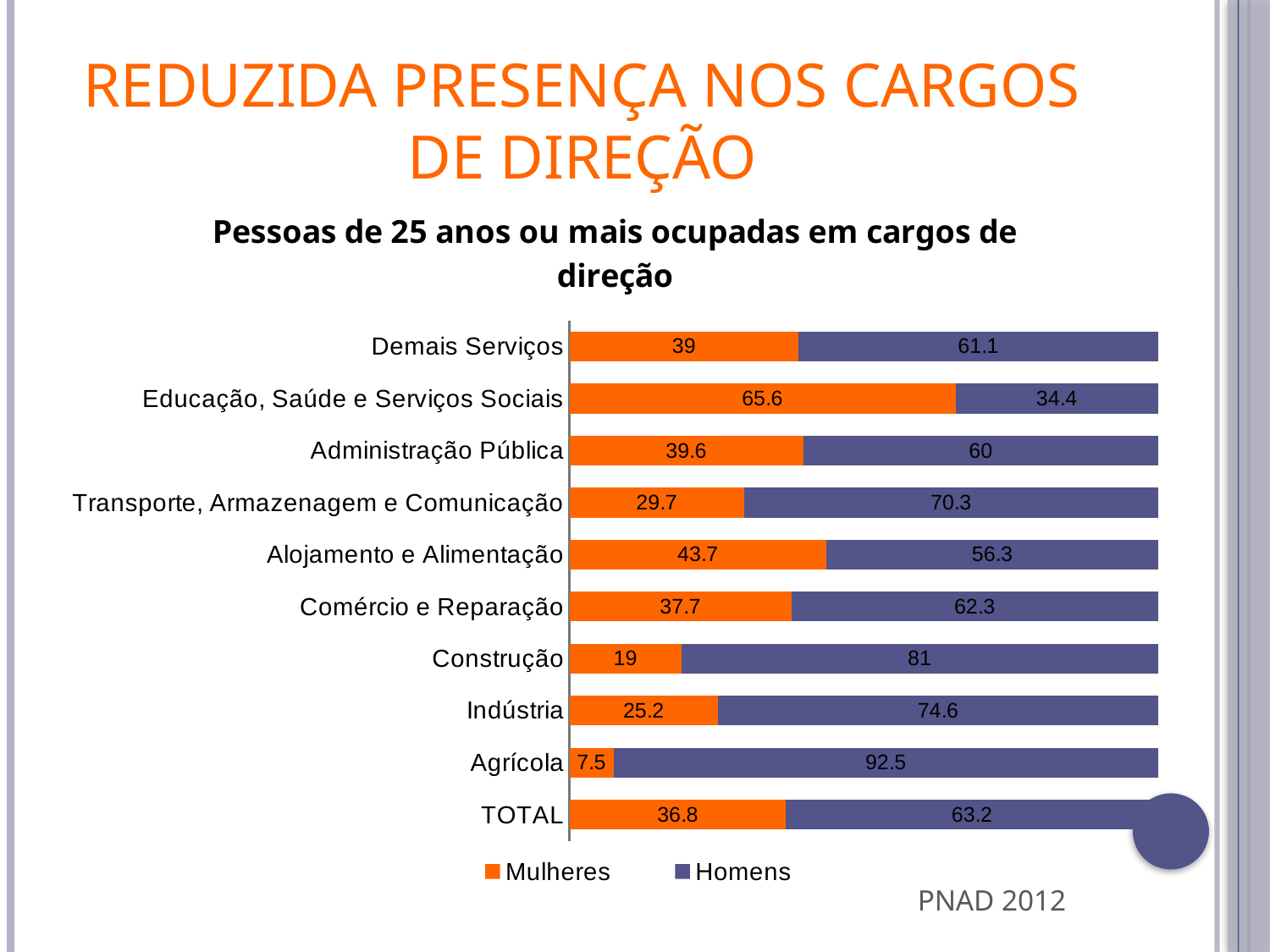
What is the Homens value for TOTAL? 63.2 How many series does the legend list? 2 Which is larger, the Mulheres value for Alojamento e Alimentação or the Mulheres value for Comércio e Reparação? Alojamento e Alimentação What is the Mulheres value for Agrícola? 7.5 What is the Mulheres value for Educação, Saúde e Serviços Sociais? 65.6 What kind of chart is shown on the slide? Stacked bar chart Which category has the highest Mulheres value? Educação, Saúde e Serviços Sociais Which category has the lowest Mulheres value? Agrícola What is the Homens value for Construção? 81 How many categories are shown on the chart? 10 Which category has the highest Homens value? Agrícola What is the difference between the Homens and Mulheres values for Indústria? 49.4